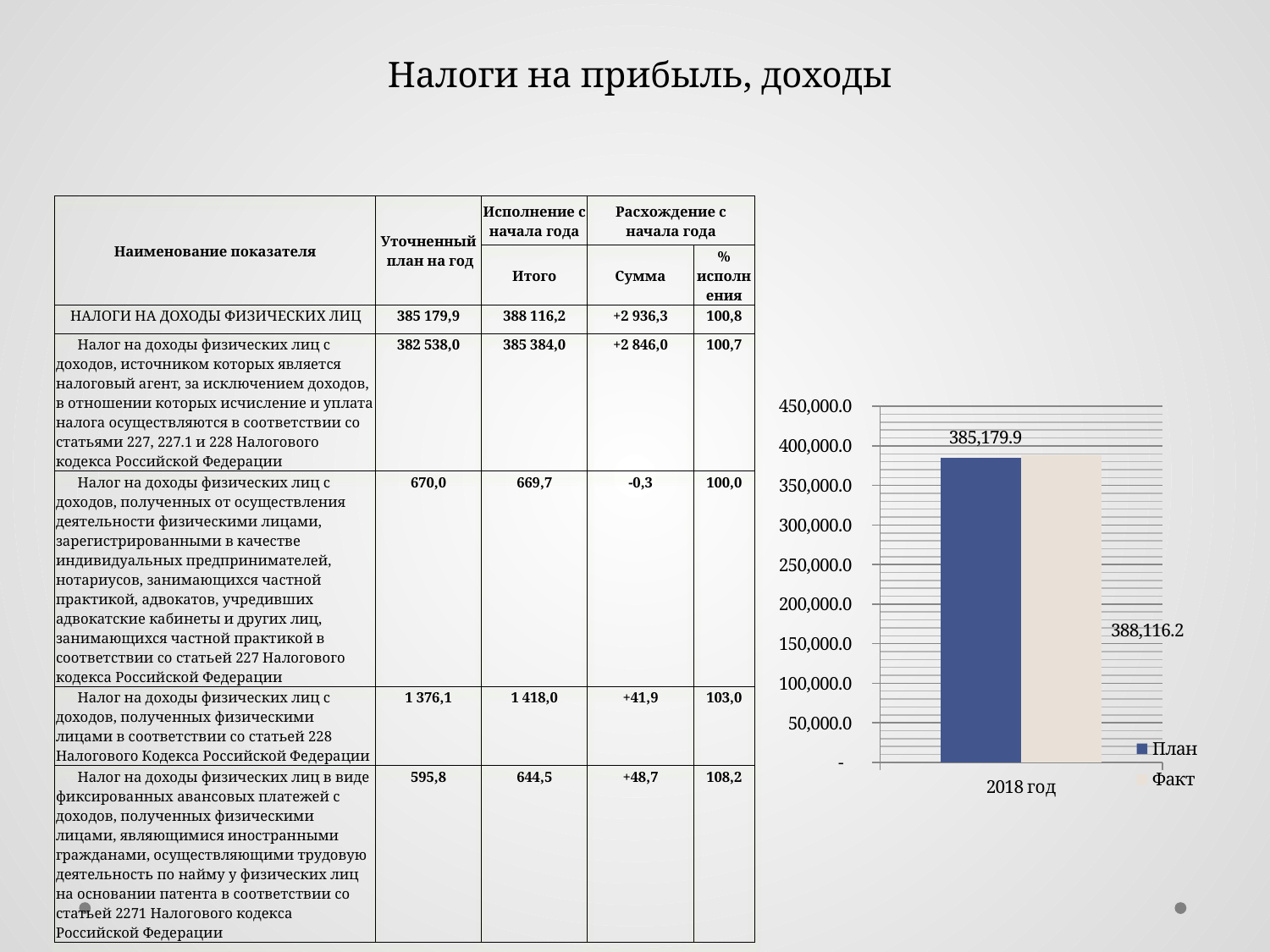
Is the value for План in the chart greater or less than 400,000.0? less How many series does the chart legend list? 2 What is the value of Факт for 2018 год in the chart? 388,116.2 What is the difference between Факт and План for 2018 год in the chart? 2,936.3 How many categories are shown on the x axis of the chart? 1 What kind of chart is shown on the right side of the slide? bar chart What is the category label on the x axis of the chart? 2018 год Which is larger in the chart for 2018 год, План or Факт? Факт What are the legend entries of the chart? План, Факт What is the value of План for 2018 год in the chart? 385,179.9 Which series has the highest value in the chart? Факт Is the value for Факт in the chart greater or less than 350,000.0? greater